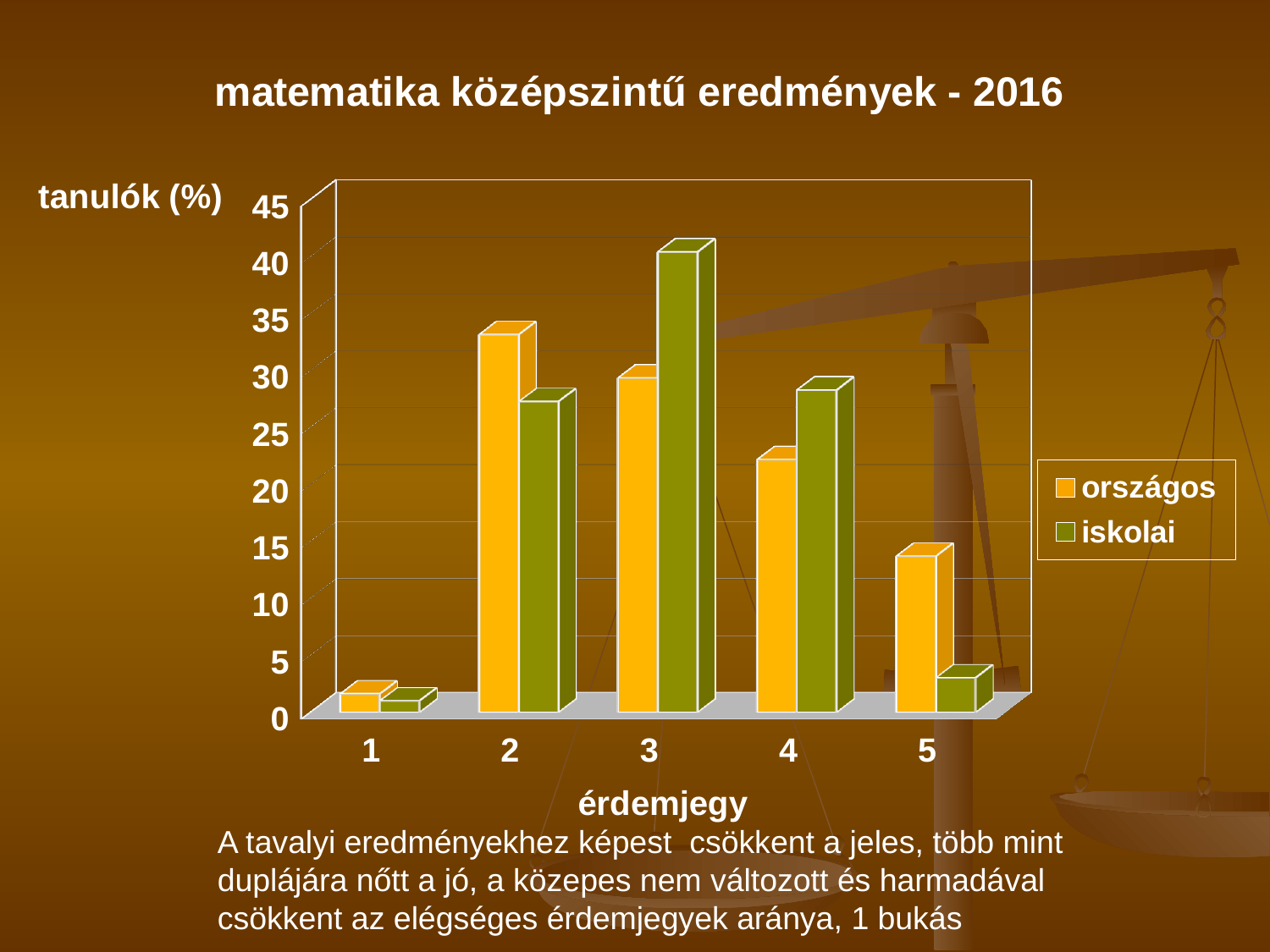
For which érdemjegy is the országos value lowest? 1 How many categories (érdemjegy values) are shown on the x axis? 5 Is the iskolai value for érdemjegy 5 greater or less than 5? less How many series does the legend list? 2 For which érdemjegy is the országos value highest? 2 Is the iskolai value for érdemjegy 3 greater or less than 35? greater Is the országos value for érdemjegy 2 greater or less than 30? greater For érdemjegy 5, which series has the larger value, országos or iskolai? országos For which érdemjegy is the iskolai value highest? 3 What is the title of the chart? matematika középszintű eredmények - 2016 For érdemjegy 3, which series has the larger value, országos or iskolai? iskolai What kind of chart is shown on the slide? bar chart